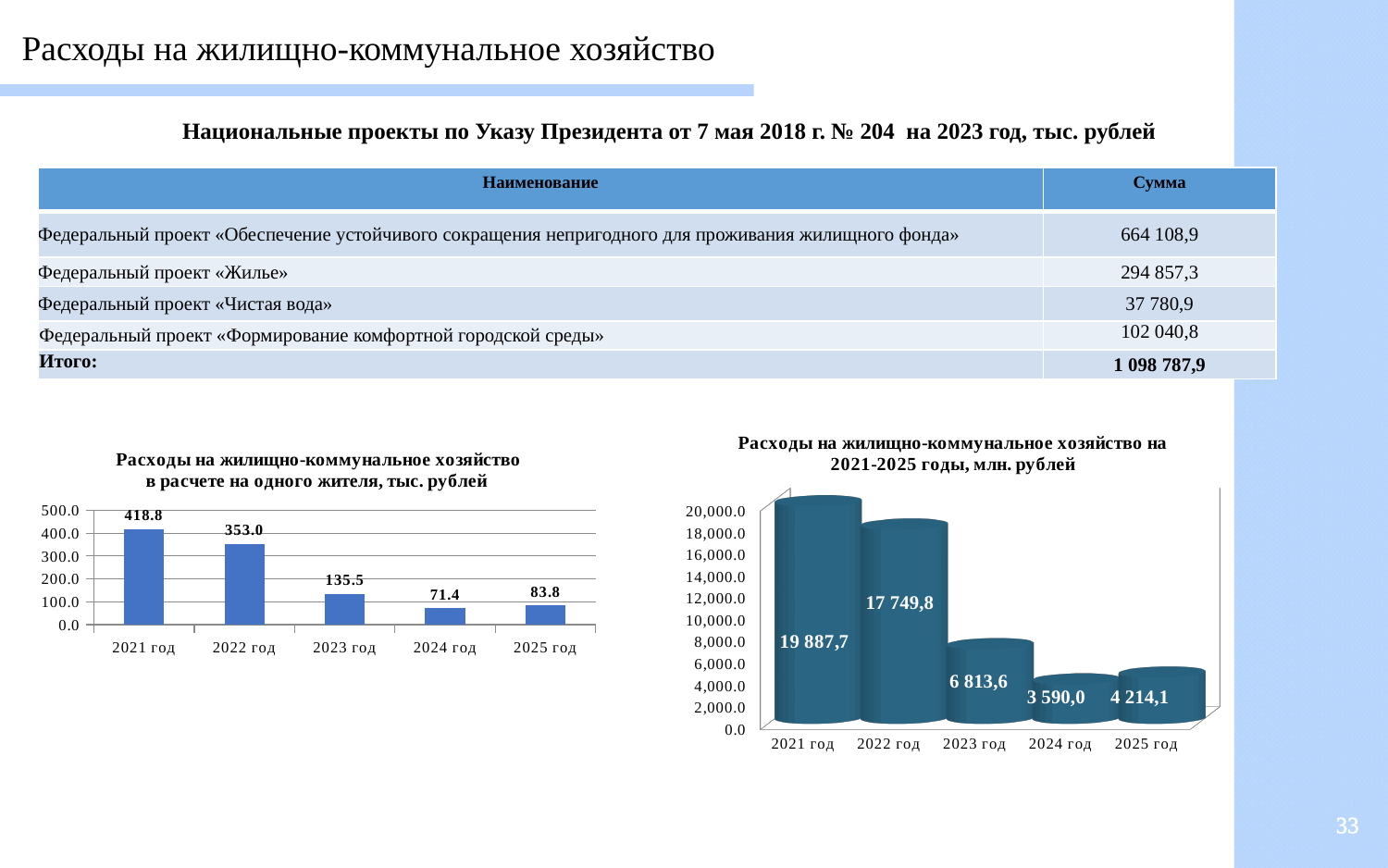
In the chart 'Расходы на жилищно-коммунальное хозяйство на 2021-2025 годы, млн. рублей', which is larger, the value for 2024 год or 2025 год? 2025 год In the chart 'Расходы на жилищно-коммунальное хозяйство на 2021-2025 годы, млн. рублей', which year has the highest value? 2021 год In the chart 'Расходы на жилищно-коммунальное хозяйство в расчете на одного жителя, тыс. рублей', which year has the lowest value? 2024 год In the chart 'Расходы на жилищно-коммунальное хозяйство в расчете на одного жителя, тыс. рублей', how many years are shown on the x axis? 5 What kind of chart is 'Расходы на жилищно-коммунальное хозяйство на 2021-2025 годы, млн. рублей'? bar chart In the chart 'Расходы на жилищно-коммунальное хозяйство в расчете на одного жителя, тыс. рублей', what is the difference between the values for 2021 год and 2022 год? 65.8 In the chart 'Расходы на жилищно-коммунальное хозяйство на 2021-2025 годы, млн. рублей', what is the value for 2025 год? 4 214,1 In the chart 'Расходы на жилищно-коммунальное хозяйство в расчете на одного жителя, тыс. рублей', what is the value for 2024 год? 71.4 In the chart 'Расходы на жилищно-коммунальное хозяйство в расчете на одного жителя, тыс. рублей', what is the value for 2021 год? 418.8 In the chart 'Расходы на жилищно-коммунальное хозяйство на 2021-2025 годы, млн. рублей', what is the value for 2022 год? 17 749,8 In the chart 'Расходы на жилищно-коммунальное хозяйство на 2021-2025 годы, млн. рублей', what is the difference between the values for 2021 год and 2023 год? 13 074,1 In the chart 'Расходы на жилищно-коммунальное хозяйство в расчете на одного жителя, тыс. рублей', is the value for 2023 год greater or less than 200.0? less